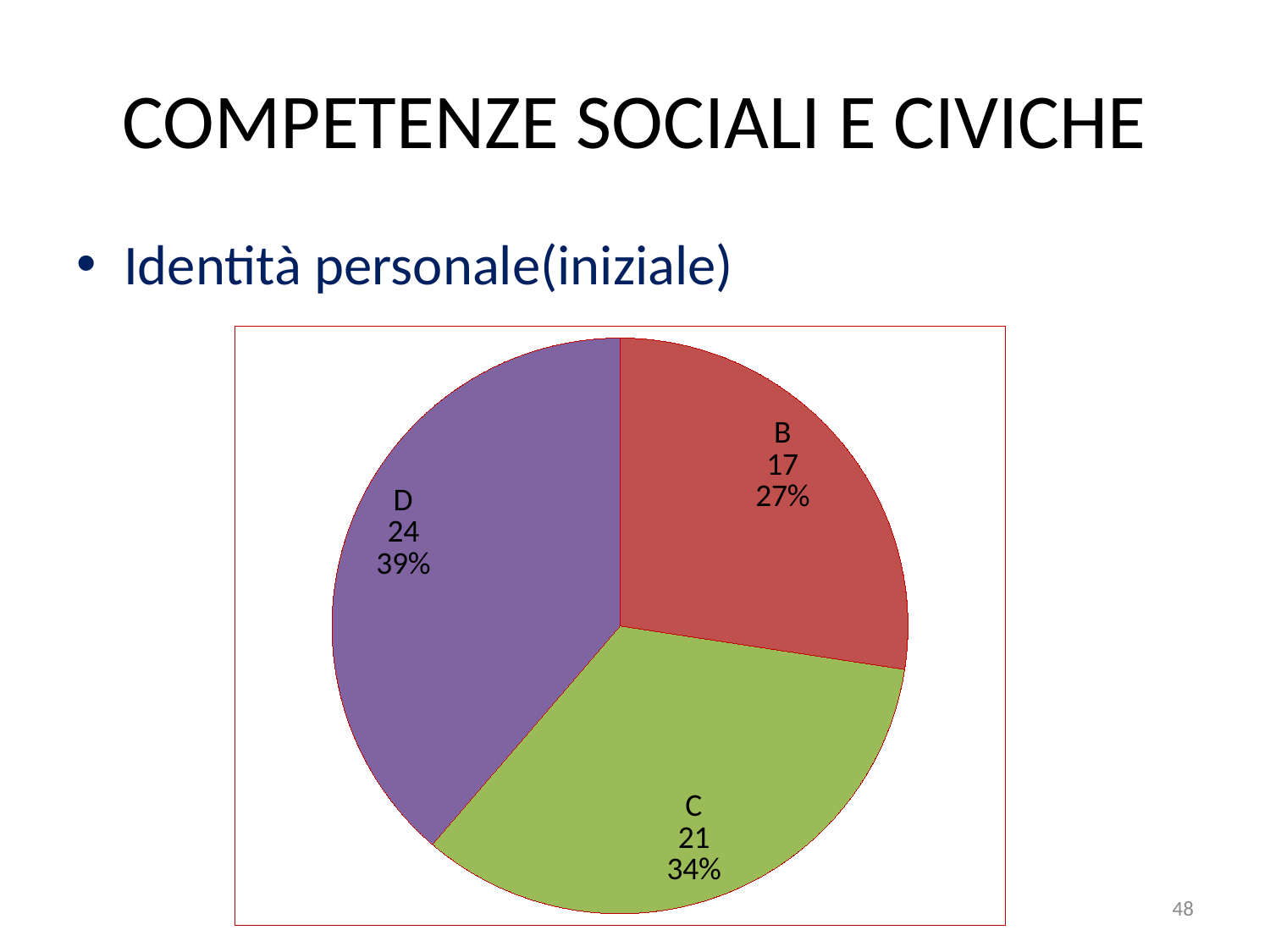
What kind of chart is shown on the slide? pie chart What percentage share does slice D have? 39% What is the value for slice B? 17 What percentage share does slice B have? 27% What is the value for slice D? 24 Which slice is the largest? D What colour is slice C? green Which is larger, the value for C or the value for B? C Which slice is the smallest? B What is the difference between the values of D and B? 7 How many slices does the pie chart have? 3 What is the value for slice C? 21